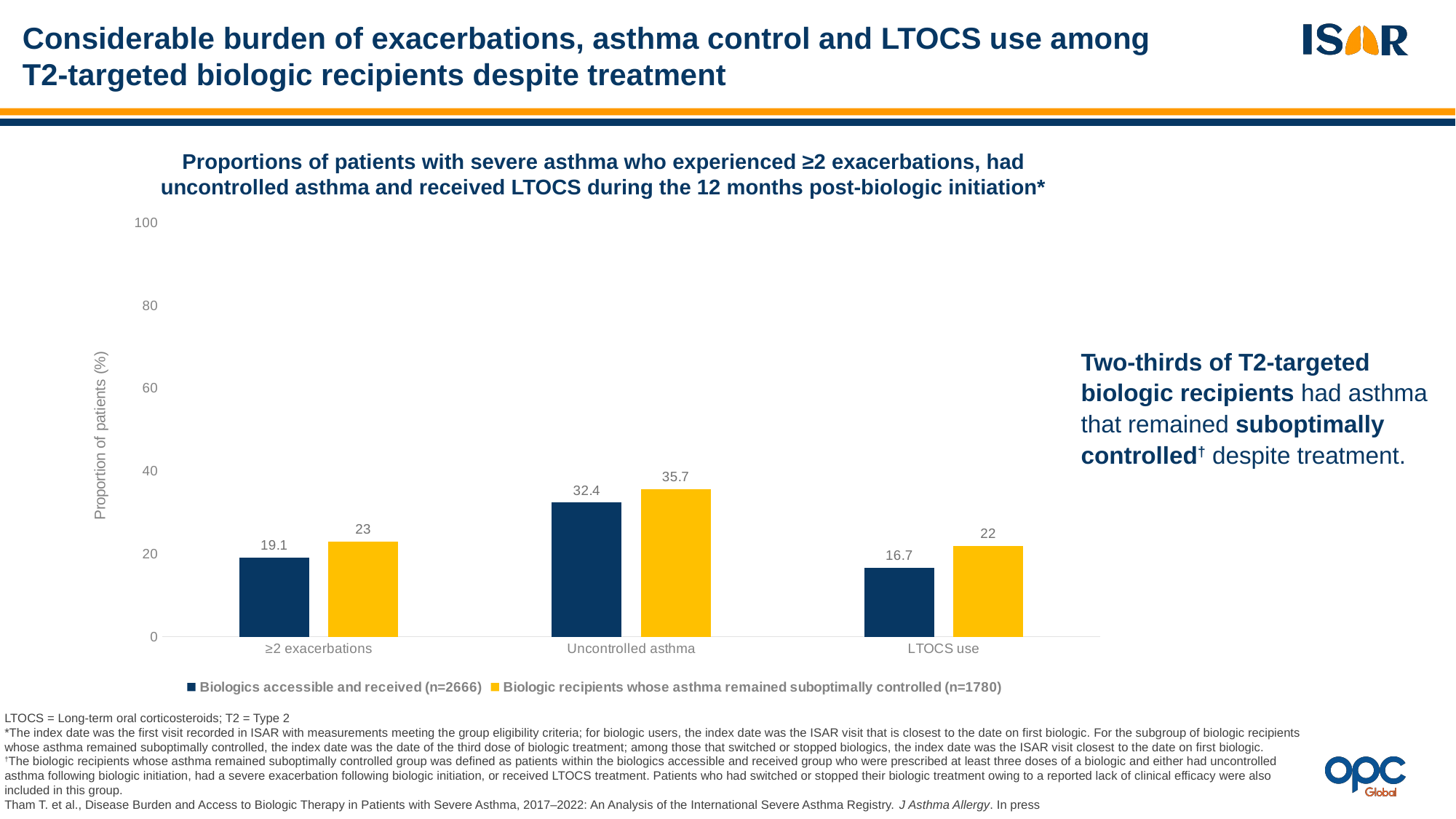
Is the value for Uncontrolled asthma in the Biologics accessible and received (n=2666) series greater or less than 40? less What is the value for Uncontrolled asthma in the Biologics accessible and received (n=2666) series? 32.4 What is the value for LTOCS use in the Biologic recipients whose asthma remained suboptimally controlled (n=1780) series? 22 Which category has the lowest value in the Biologics accessible and received (n=2666) series? LTOCS use What kind of chart is shown on the slide? Bar chart What is the difference between the two series for LTOCS use? 5.3 Which category has the highest value in the Biologic recipients whose asthma remained suboptimally controlled (n=1780) series? Uncontrolled asthma How many categories are shown on the x axis? 3 How many series does the legend list? 2 What is the difference between the two series for Uncontrolled asthma? 3.3 For ≥2 exacerbations, which series has the larger value? Biologic recipients whose asthma remained suboptimally controlled (n=1780) What is the value for ≥2 exacerbations in the Biologics accessible and received (n=2666) series? 19.1